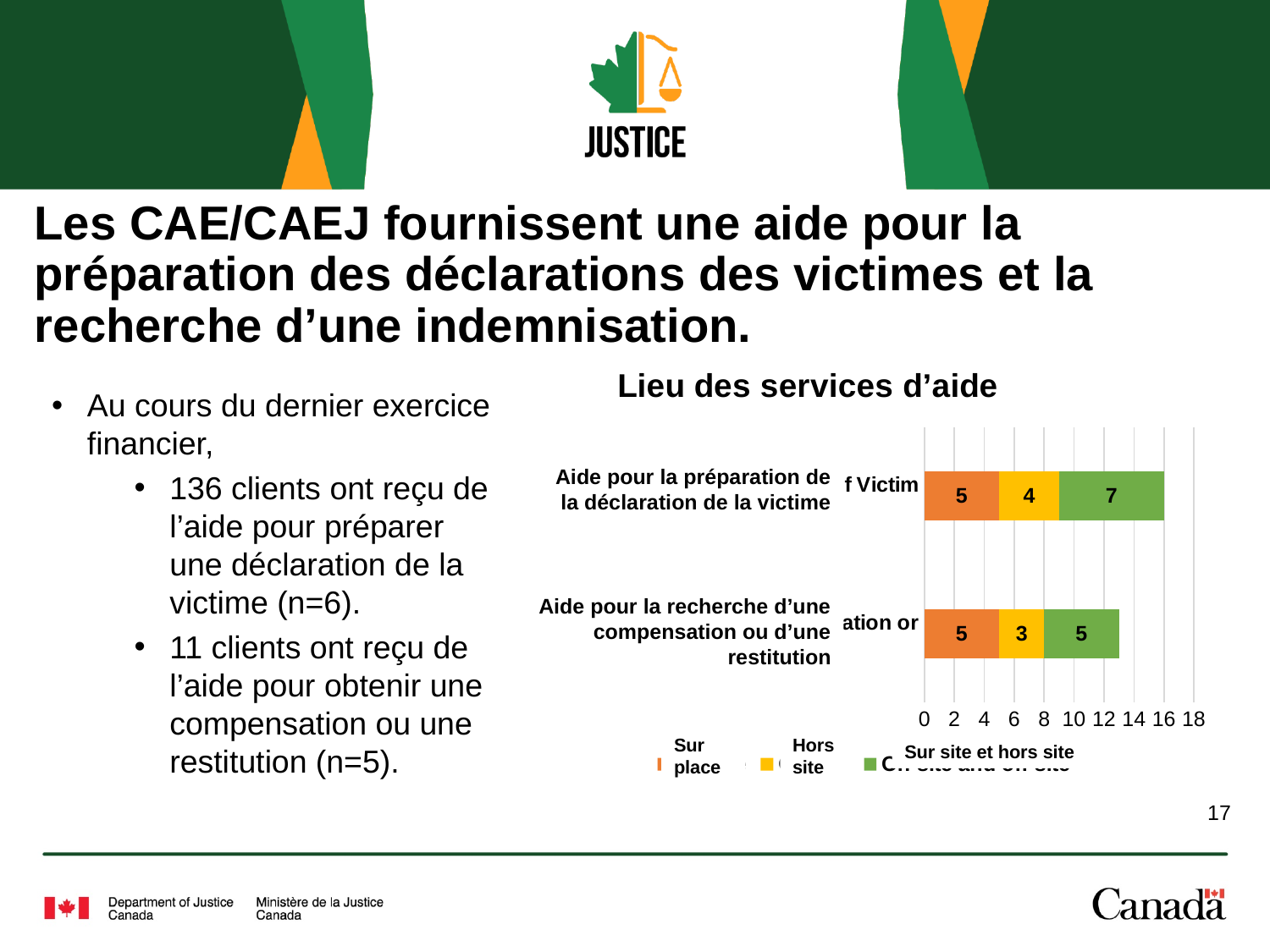
How many series does the legend of the "Lieu des services d'aide" chart list? 3 What is the "Hors site" value for "Aide pour la recherche d'une compensation ou d'une restitution"? 3 What is the difference between the "Sur site et hors site" values for the two categories? 2 What is the "Sur site et hors site" value for "Aide pour la recherche d'une compensation ou d'une restitution"? 5 What type of chart is shown under the title "Lieu des services d'aide"? Stacked bar chart What is the "Sur site et hors site" value for "Aide pour la préparation de la déclaration de la victime"? 7 What is the total of the stacked bar for "Aide pour la recherche d'une compensation ou d'une restitution"? 13 What is the "Sur place" value for "Aide pour la préparation de la déclaration de la victime"? 5 Which category has the larger "Hors site" value? Aide pour la préparation de la déclaration de la victime How many categories are plotted in the "Lieu des services d'aide" chart? 2 What is the total of the stacked bar for "Aide pour la préparation de la déclaration de la victime"? 16 What is the "Hors site" value for "Aide pour la préparation de la déclaration de la victime"? 4